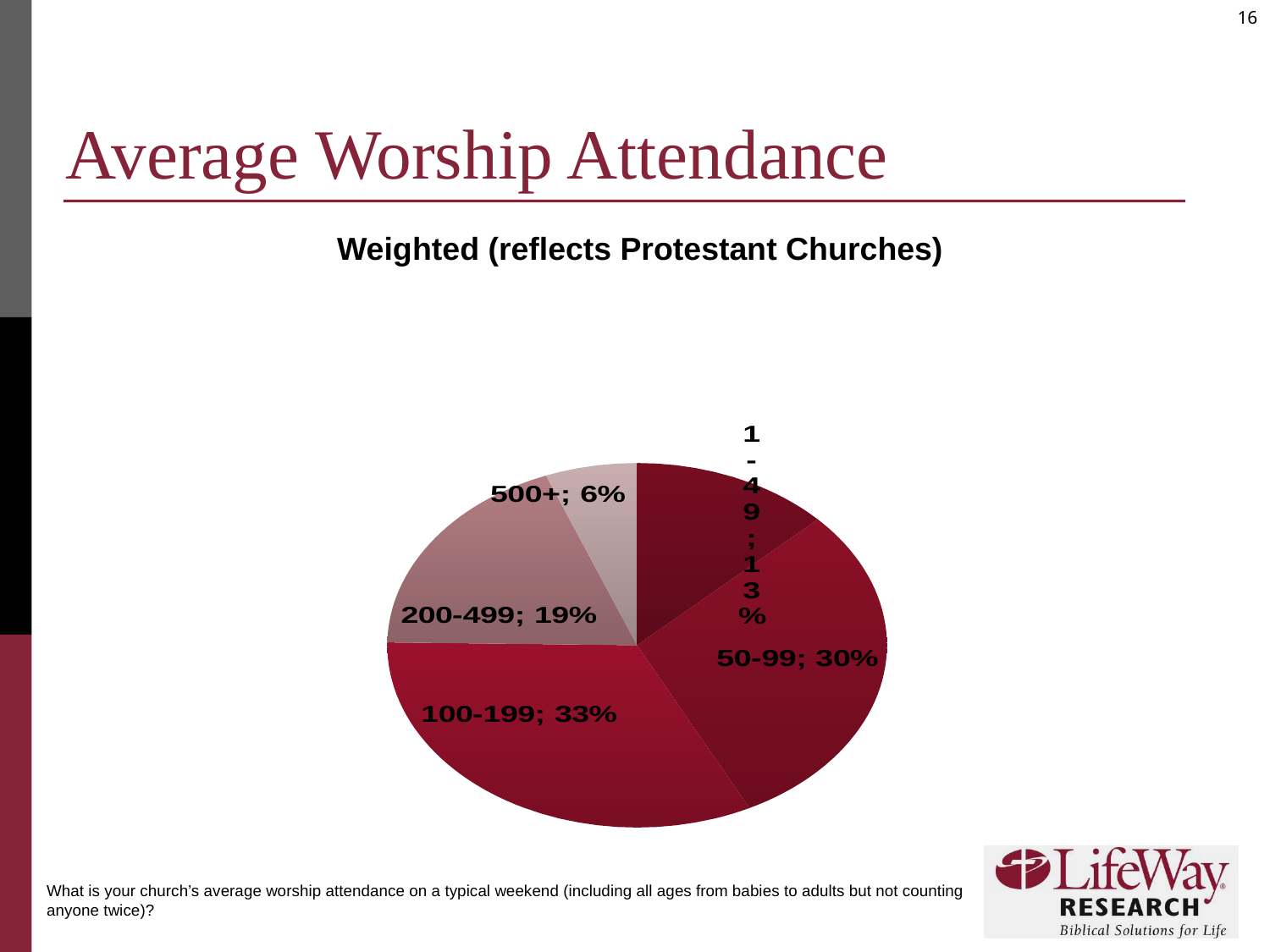
What kind of chart is shown on the slide? Pie chart How many attendance categories are shown in the pie chart? 5 What share of churches have an average worship attendance of 1-49? 13% What is the difference in percentage points between the 100-199 slice and the 200-499 slice? 14 Which attendance category has the smallest slice of the pie? 500+ Which is larger, the share for 1-49 or the share for 200-499? 200-499 What share of churches have an average worship attendance of 50-99? 30% Which attendance category has the largest slice of the pie? 100-199 What share of churches have an average worship attendance of 500+? 6% What share of churches have an average worship attendance of 200-499? 19% What is the subtitle shown above the pie chart? Weighted (reflects Protestant Churches) What share of churches have an average worship attendance of 100-199? 33%